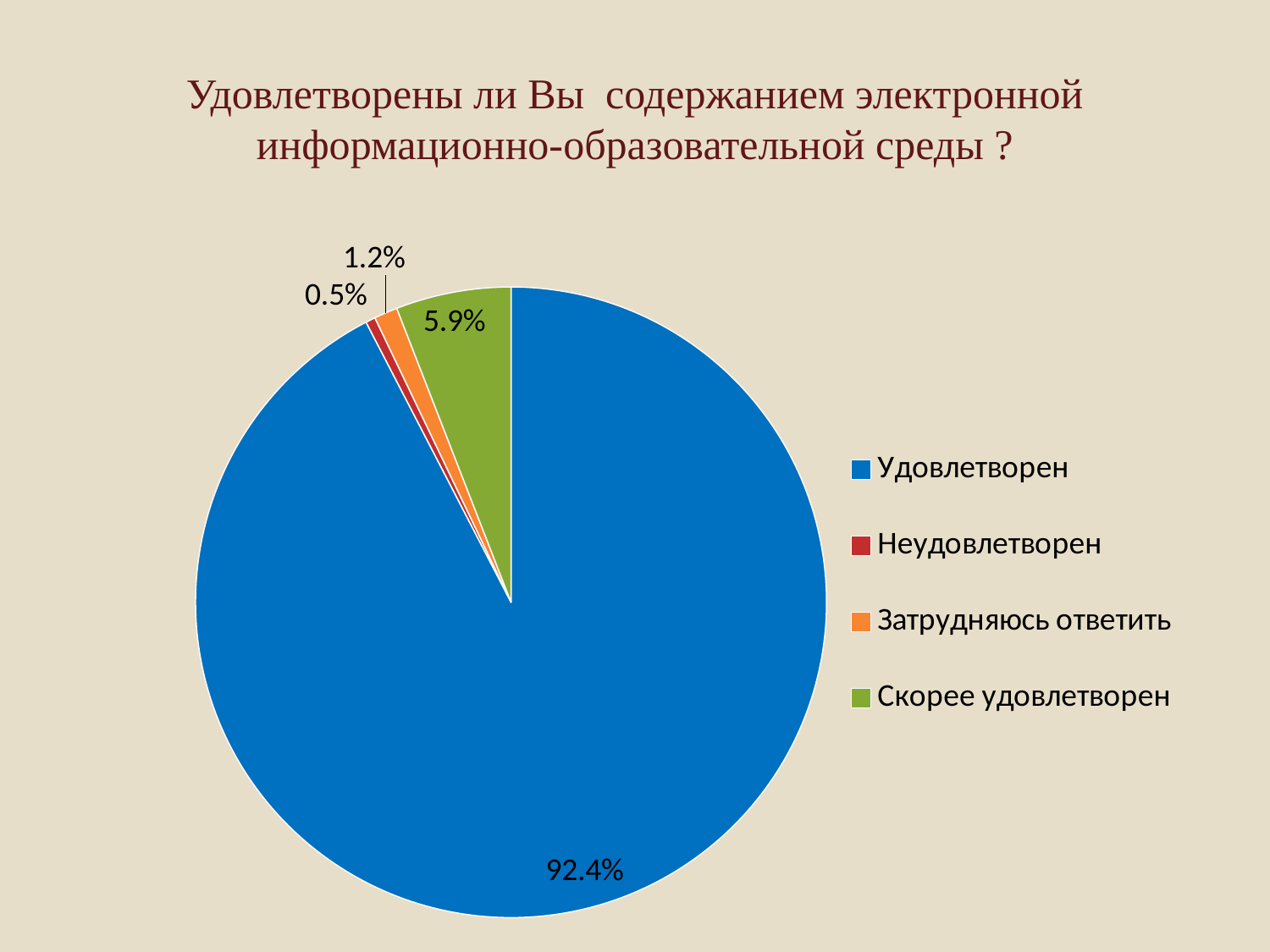
Which is larger: the share for "Затрудняюсь ответить" or for "Неудовлетворен"? Затрудняюсь ответить What colour is the slice for "Скорее удовлетворен"? Green What is the difference in percentage points between "Удовлетворен" and "Скорее удовлетворен"? 86.5 What share of respondents answered "Скорее удовлетворен"? 5.9% Which answer has the largest slice of the pie? Удовлетворен What is the combined share of "Неудовлетворен" and "Затрудняюсь ответить"? 1.7% What share of respondents answered "Неудовлетворен"? 0.5% Which answer has the smallest slice of the pie? Неудовлетворен How many slices does the pie chart have? 4 What kind of chart is shown on the slide? Pie chart What share of respondents answered "Затрудняюсь ответить"? 1.2% What share of respondents answered "Удовлетворен"? 92.4%